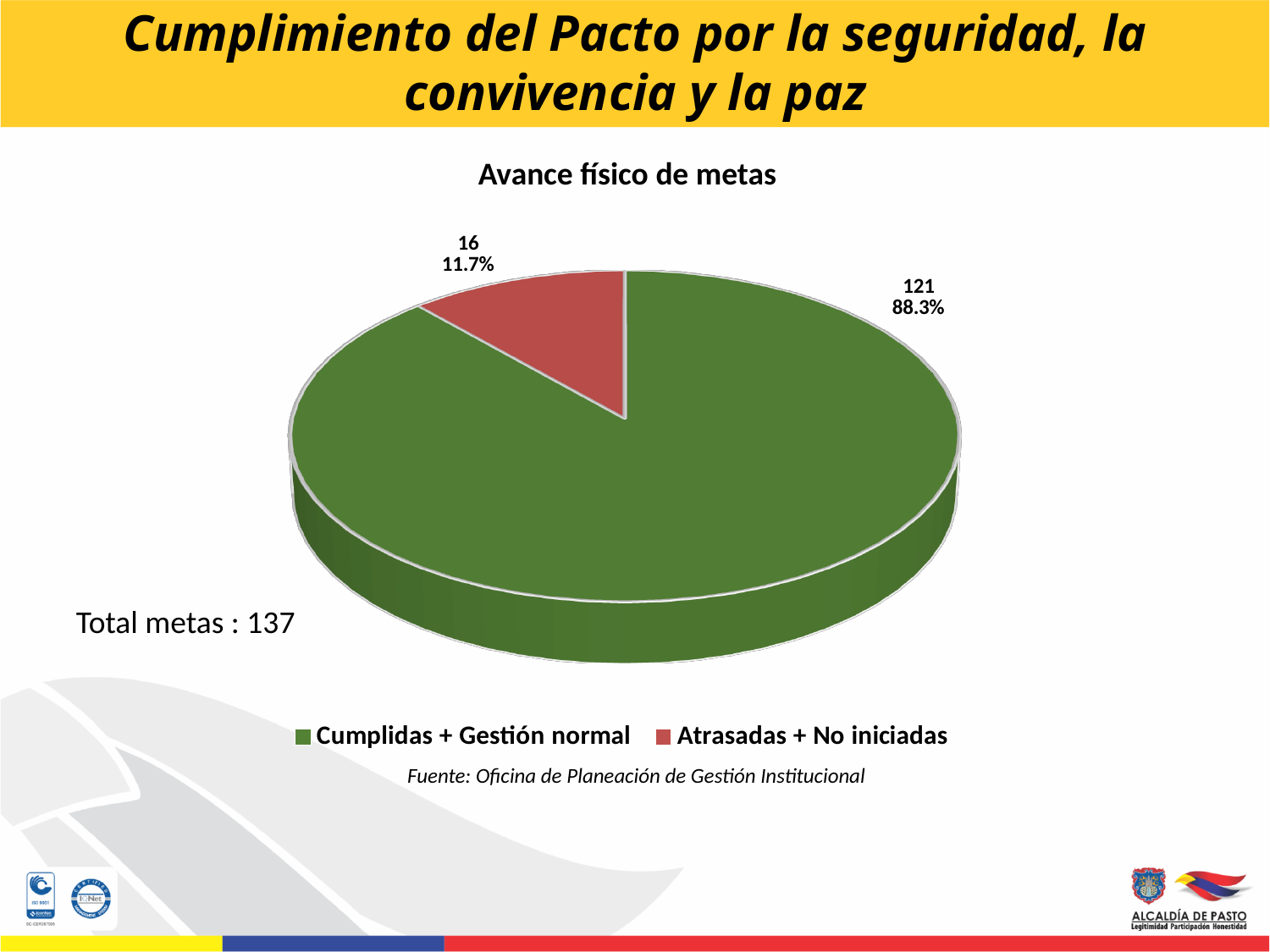
What share of the pie does Atrasadas + No iniciadas represent? 11.7% How many slices does the pie chart have? 2 How many entries does the legend list? 2 What is the chart's title? Avance físico de metas What colour is the slice for Atrasadas + No iniciadas? red What is the value for Atrasadas + No iniciadas? 16 What is the value for Cumplidas + Gestión normal? 121 What kind of chart is shown on the slide? pie chart What share of the pie does Cumplidas + Gestión normal represent? 88.3% What is the difference between the values for Cumplidas + Gestión normal and Atrasadas + No iniciadas? 105 Which category has the largest slice? Cumplidas + Gestión normal Which category has the smallest slice? Atrasadas + No iniciadas